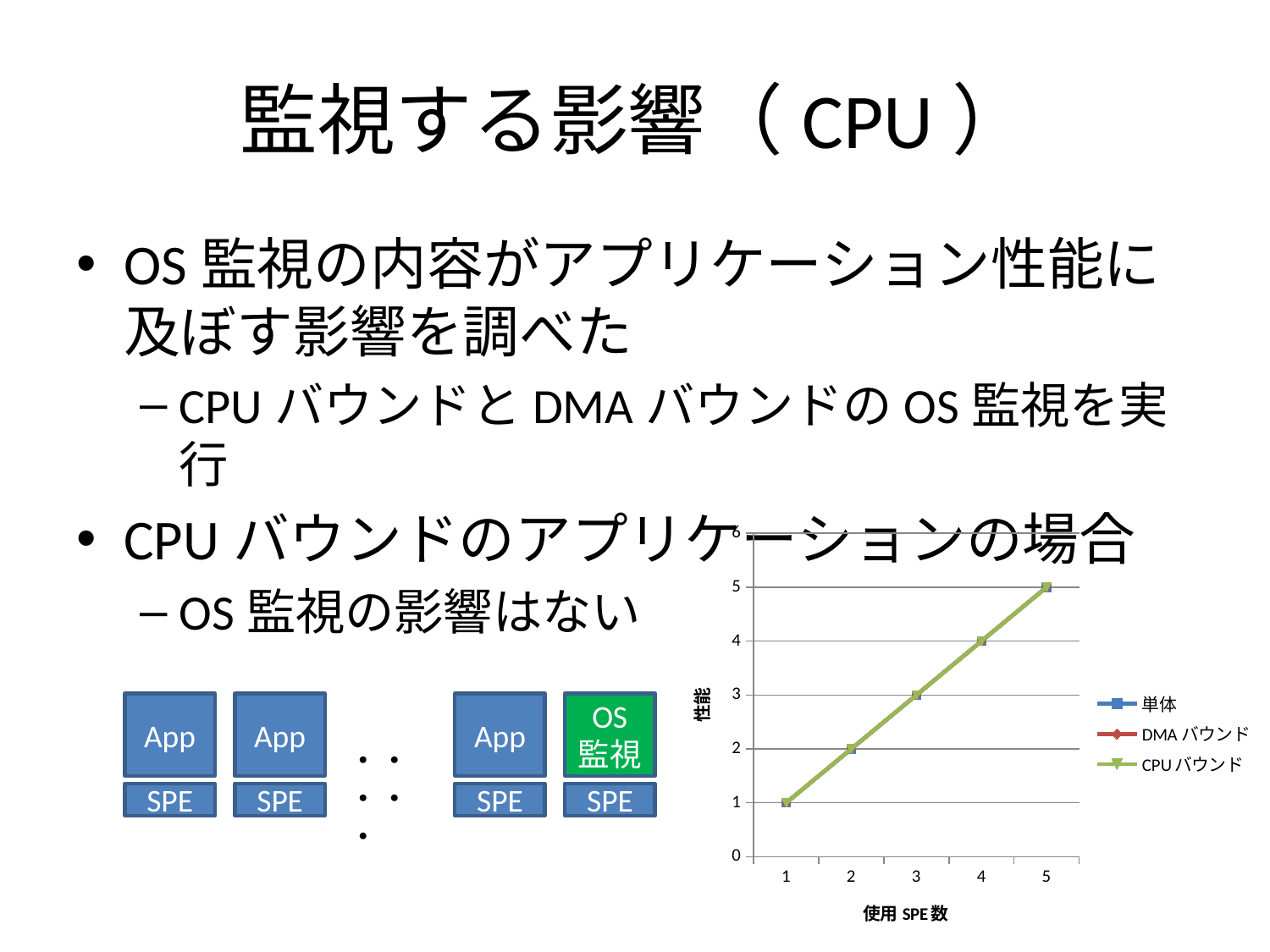
What is the 性能 value for the CPU バウンド series when 使用 SPE 数 is 3? 3 What is the 性能 value for the DMA バウンド series when 使用 SPE 数 is 1? 1 What are the series names listed in the chart legend? 単体, DMA バウンド, CPU バウンド What is the 性能 value for the 単体 series when 使用 SPE 数 is 5? 5 At which 使用 SPE 数 value is 性能 highest for the 単体 series? 5 How many series does the chart legend list? 3 How many points along the x axis (使用 SPE 数) are plotted for each series? 5 At which 使用 SPE 数 value is 性能 lowest for the CPU バウンド series? 1 Do the 性能 values rise or fall as 使用 SPE 数 increases from 1 to 5? rise What kind of chart is shown on the slide? line chart What is the x-axis title of the chart? 使用 SPE 数 What is the difference in 性能 for the 単体 series between 使用 SPE 数 5 and 使用 SPE 数 2? 3